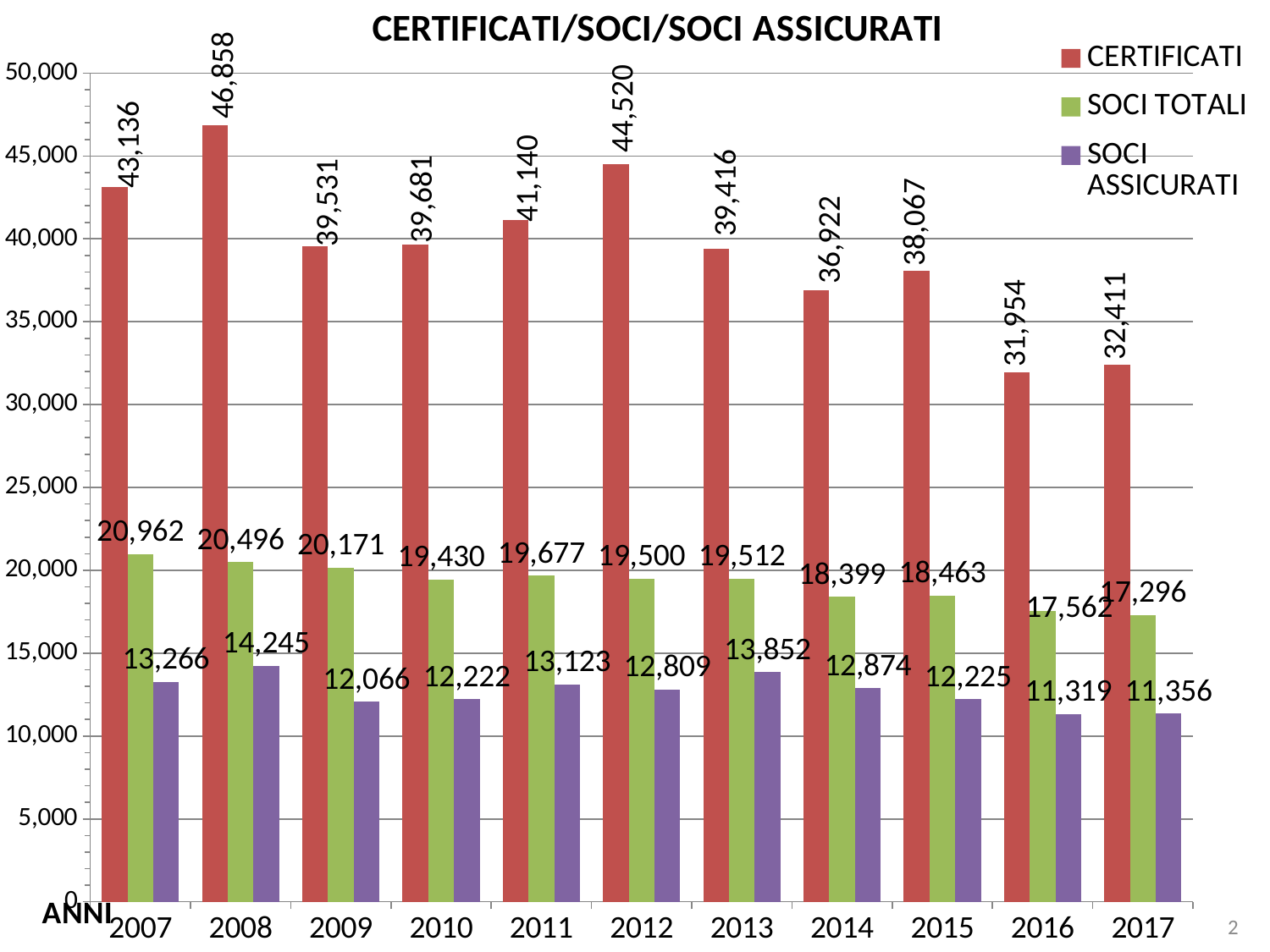
In which year is the CERTIFICATI value highest? 2008 Does the SOCI TOTALI series generally rise or fall from 2007 to 2017? fall What is the difference between the CERTIFICATI values for 2008 and 2007? 3,722 How many series does the legend list? 3 Which year has the larger SOCI TOTALI value, 2014 or 2015? 2015 Is the CERTIFICATI value for 2014 greater or less than 35,000? greater What is the SOCI ASSICURATI value for 2013? 13,852 In which year is the CERTIFICATI value lowest? 2016 How many years are shown on the x axis? 11 What is the SOCI TOTALI value for 2010? 19,430 In which year is the SOCI ASSICURATI value highest? 2008 What is the CERTIFICATI value for 2012? 44,520